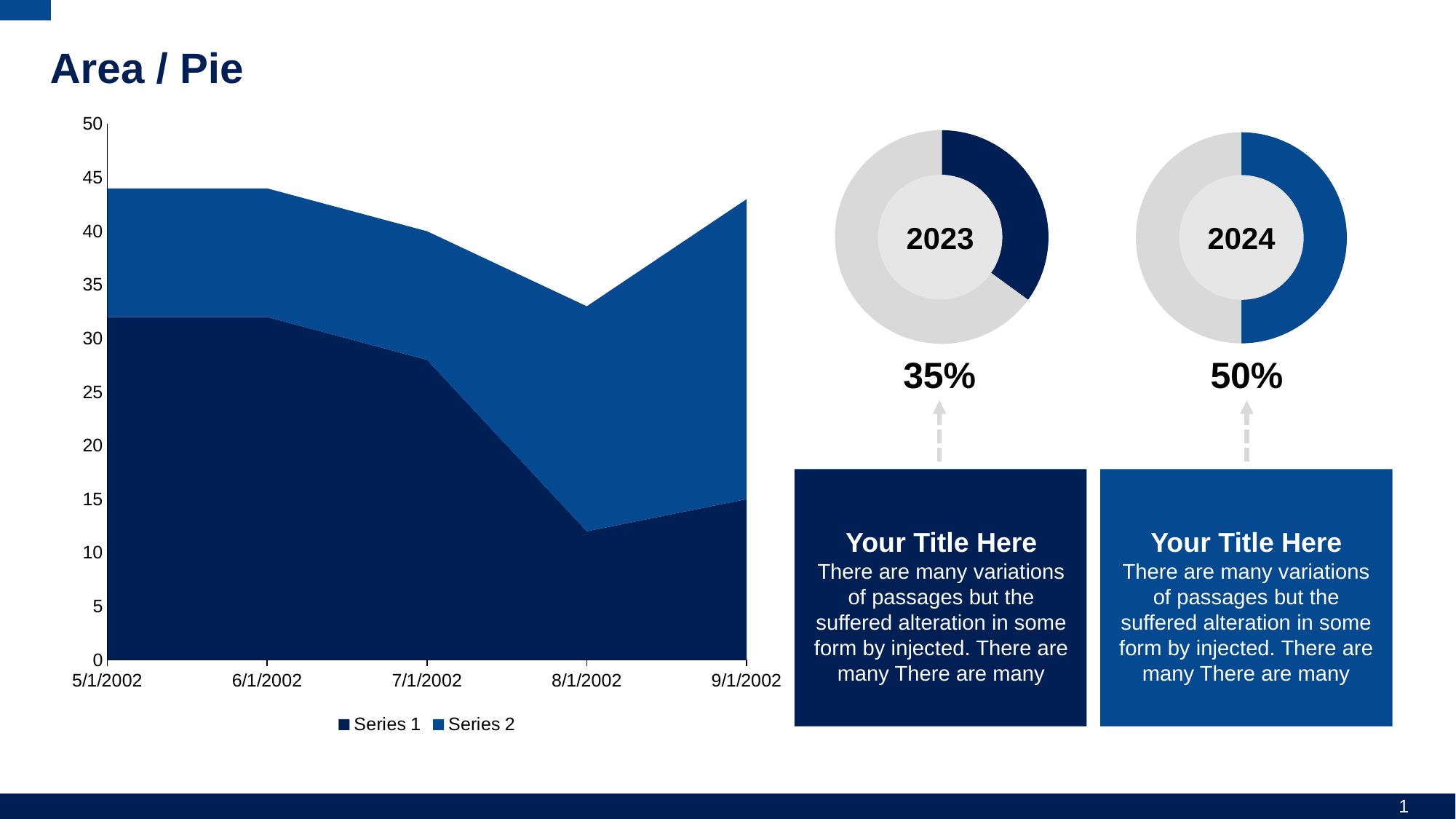
In the 2023 pie chart, what percentage is shown? 35% In the area chart, is the value for Series 1 at 7/1/2002 greater or less than 30? less In the area chart, is the value for Series 1 at 8/1/2002 greater or less than 20? less In the area chart, how many dates are shown on the x axis? 5 What kind of chart is shown on the left side of the slide? area chart In the area chart, how many series does the legend list? 2 In the area chart, what are the names of the two series in the legend? Series 1 and Series 2 In the 2024 pie chart, what percentage is shown? 50% What kind of charts are the two charts labelled 2023 and 2024 on the right side of the slide? pie (donut) charts In the area chart, is the value for Series 1 at 5/1/2002 greater or less than 30? greater In the area chart, does Series 1 rise or fall from 5/1/2002 to 8/1/2002? fall Which pie chart shows the larger percentage, 2023 or 2024? 2024